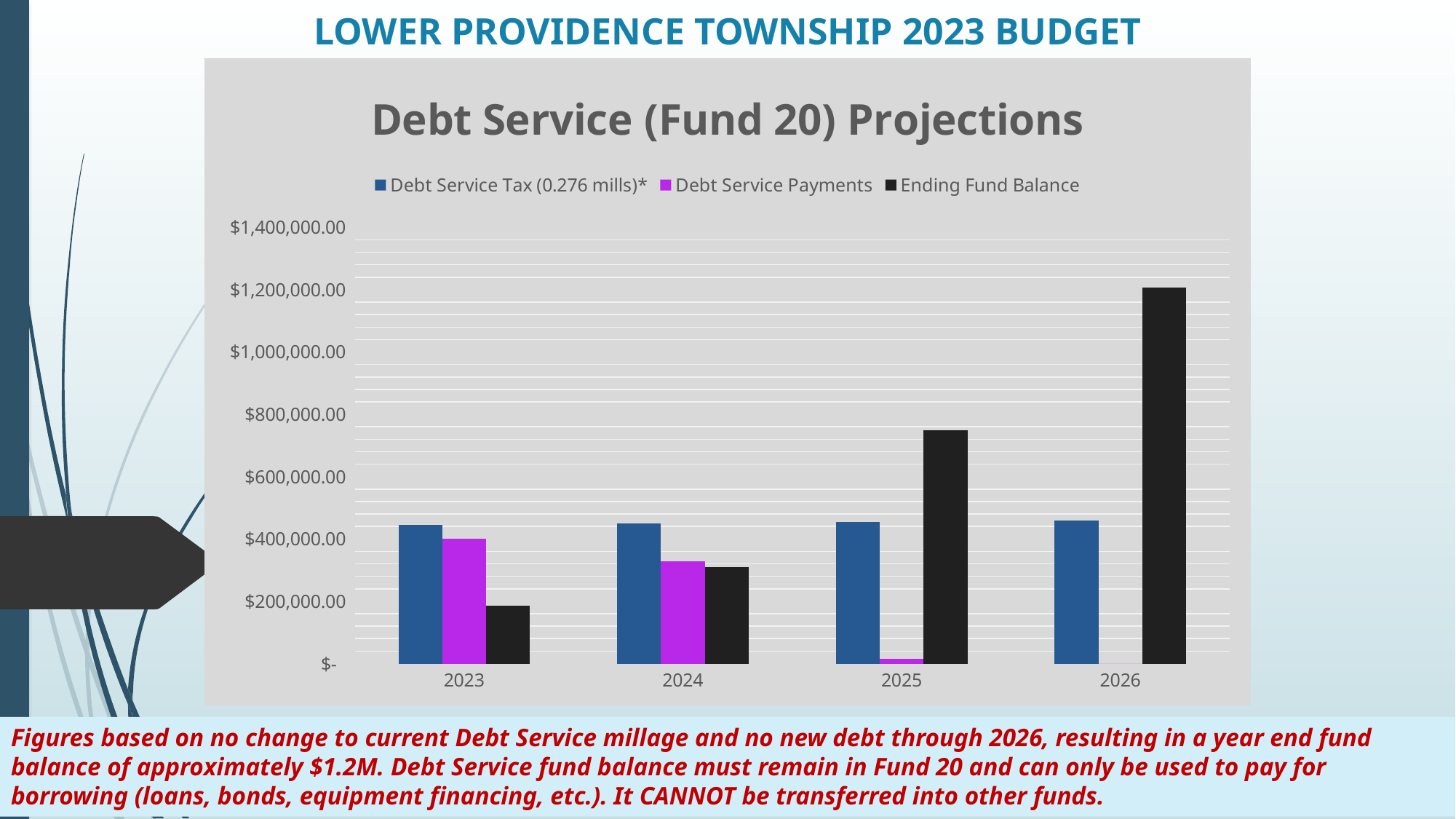
How many series does the legend of the chart list? 3 How many years are shown on the x axis of the chart? 4 In 2023, which is larger: Debt Service Payments or Ending Fund Balance? Debt Service Payments In which year is the Ending Fund Balance highest? 2026 Do the Debt Service Payments rise or fall from 2023 to 2025? Fall Is the Ending Fund Balance for 2025 greater or less than $600,000.00? greater What kind of chart is shown on the slide? Bar chart Is the Ending Fund Balance for 2026 greater or less than $1,000,000.00? greater Does the Ending Fund Balance rise or fall from 2023 to 2026? Rise In which year is the Ending Fund Balance lowest? 2023 Is the Debt Service Tax (0.276 mills)* for 2023 greater or less than $400,000.00? greater What is the title of the chart? Debt Service (Fund 20) Projections